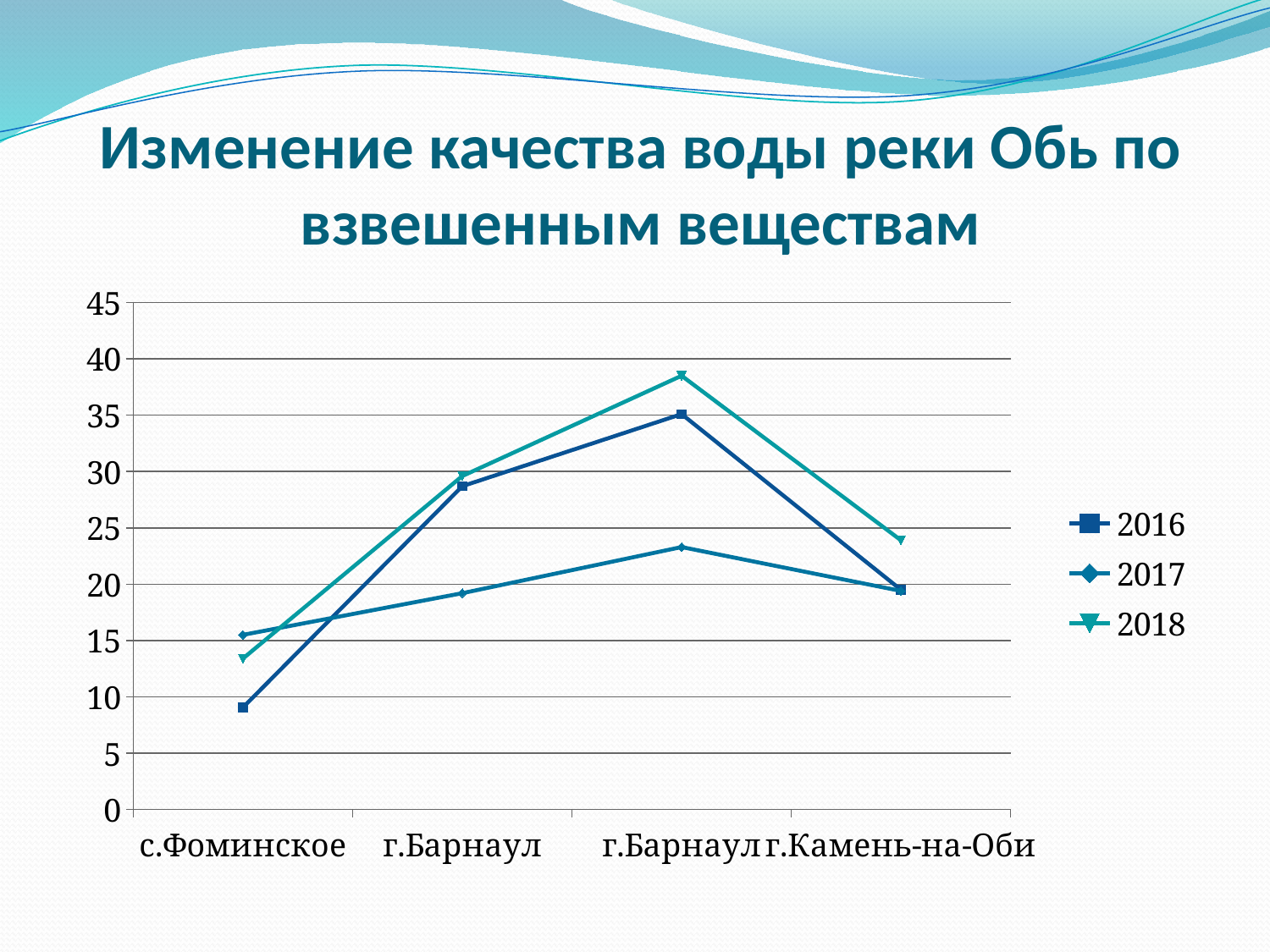
Is the value for с.Фоминское in the 2016 series greater or less than 10? less Is the value for г.Камень-на-Оби in the 2018 series greater or less than 20? greater Which series are listed in the legend? 2016, 2017, 2018 What kind of chart is shown on the slide? line chart Which series has the lowest value at с.Фоминское? 2016 What is the title of the chart on the slide? Изменение качества воды реки Обь по взвешенным веществам Which is larger at г.Камень-на-Оби: the 2018 value or the 2017 value? 2018 Which series has the highest value at the third point on the x axis? 2018 How many points are plotted along the x axis for each series? 4 How many series does the legend list? 3 Is the highest value of the 2018 series greater or less than 35? greater